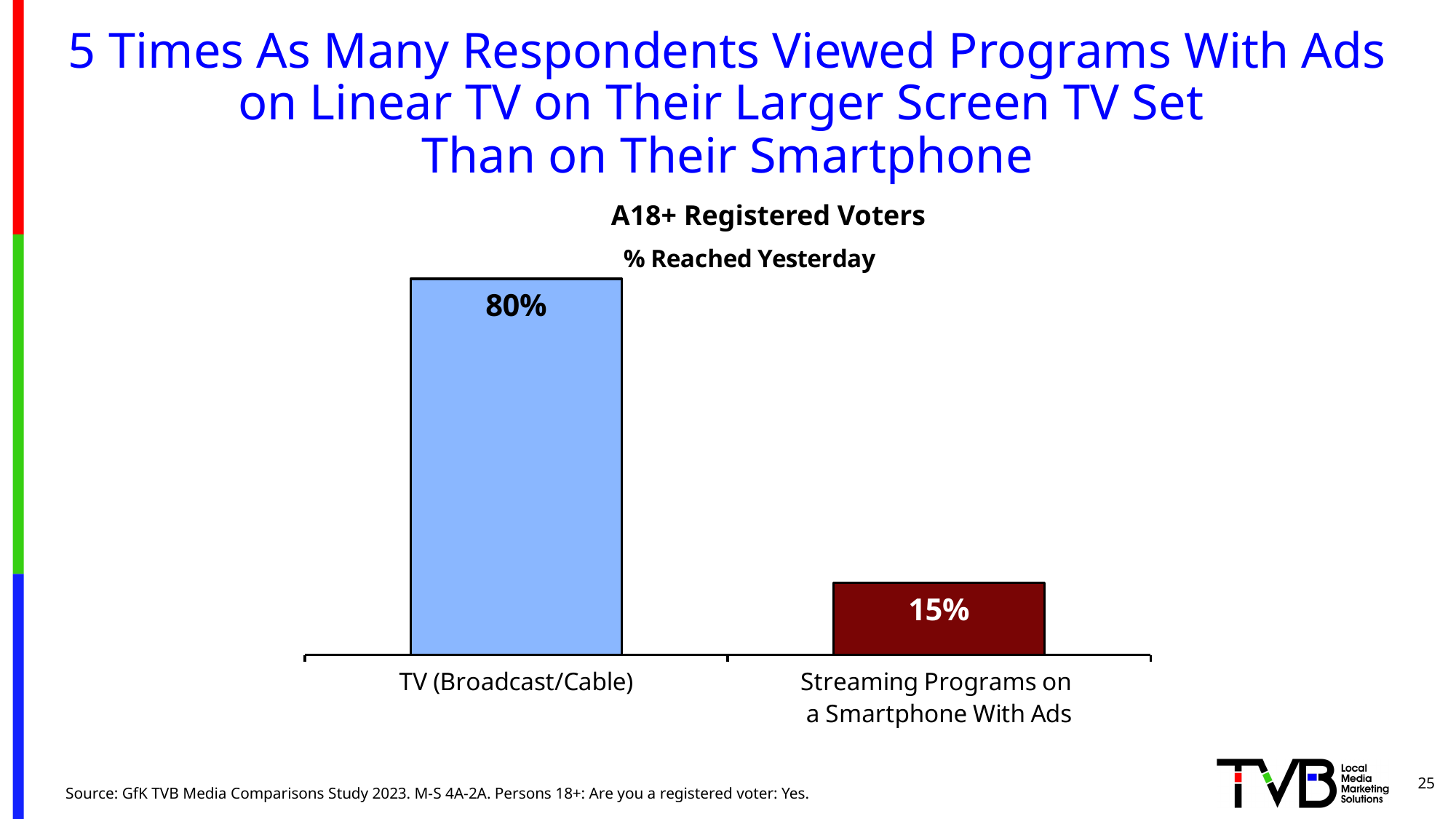
How many categories are shown in the chart? 2 What kind of chart is shown on the slide? Bar chart Which is larger: the % reached yesterday for TV (Broadcast/Cable) or for Streaming Programs on a Smartphone With Ads? TV (Broadcast/Cable) What is the % reached yesterday for Streaming Programs on a Smartphone With Ads? 15% What is the % reached yesterday for TV (Broadcast/Cable)? 80% Which category has the highest % reached yesterday? TV (Broadcast/Cable) Which category has the lowest % reached yesterday? Streaming Programs on a Smartphone With Ads What colour is the bar for TV (Broadcast/Cable)? Light blue What is the title of the chart? % Reached Yesterday What is the difference in % reached yesterday between TV (Broadcast/Cable) and Streaming Programs on a Smartphone With Ads? 65%